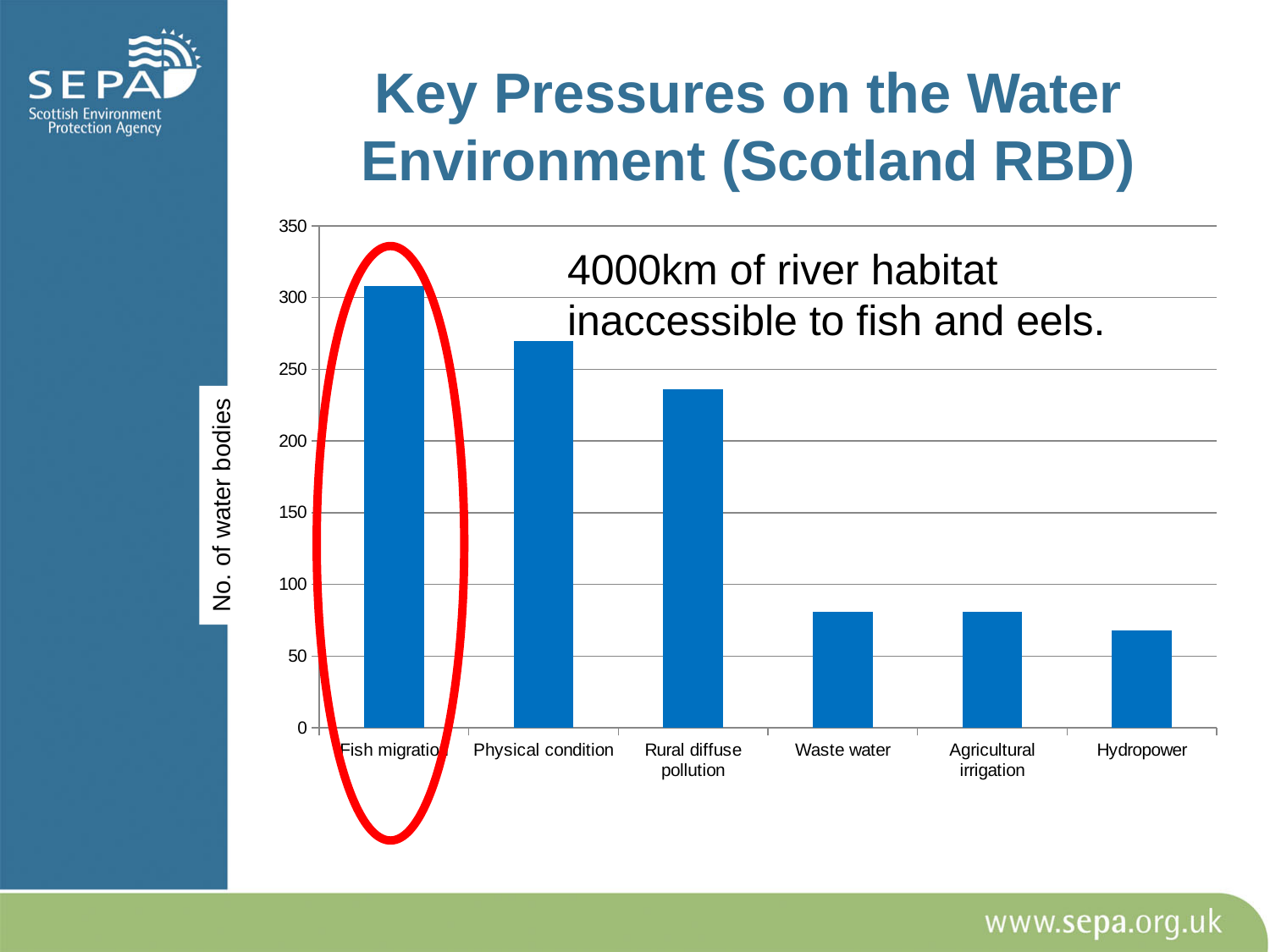
Which pressure has the highest number of water bodies? Fish migration What kind of chart is shown on the slide? bar chart What is the label of the y axis of the chart? No. of water bodies Is the value for Rural diffuse pollution greater or less than 250? less Is the value for Waste water greater or less than 100? less Which pressure has the lowest number of water bodies? Hydropower How many categories (pressures) are shown on the x axis of the chart? 6 Which is larger, the value for Physical condition or the value for Rural diffuse pollution? Physical condition Is the value for Hydropower greater or less than 50? greater Do the values generally rise or fall moving from left to right along the x axis? fall